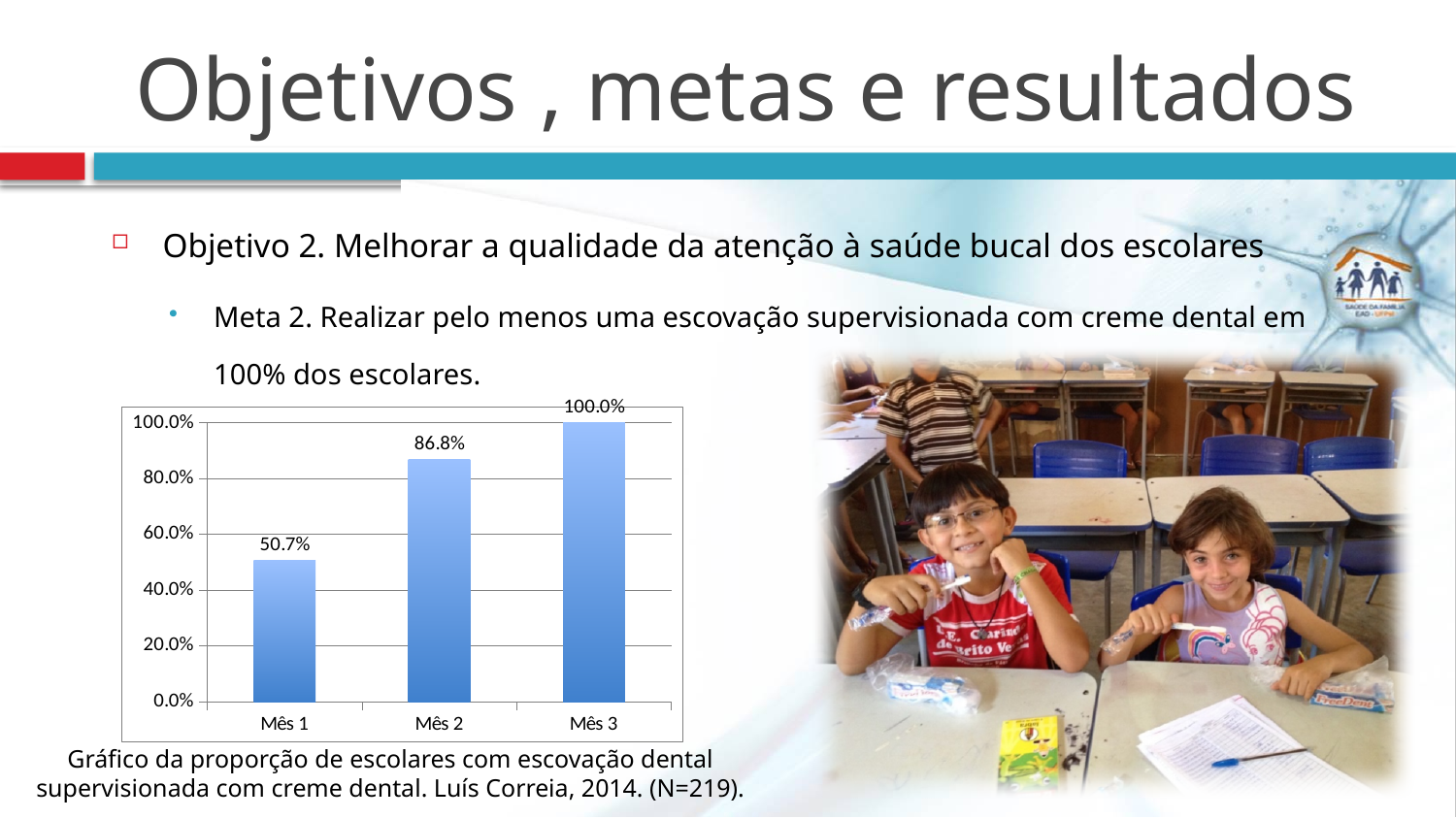
What is the value for Mês 1? 50.7% What is the value for Mês 2? 86.8% What kind of chart is shown on the slide? bar chart What is the difference between the values for Mês 3 and Mês 2? 13.2% Do the values rise or fall from Mês 1 to Mês 3? rise What is the difference between the values for Mês 2 and Mês 1? 36.1% Which month has the highest value? Mês 3 Which is larger, the value for Mês 1 or the value for Mês 2? Mês 2 How many months are shown on the x axis? 3 What is the value for Mês 3? 100.0% Is the value for Mês 1 greater or less than 60.0%? less Which month has the lowest value? Mês 1